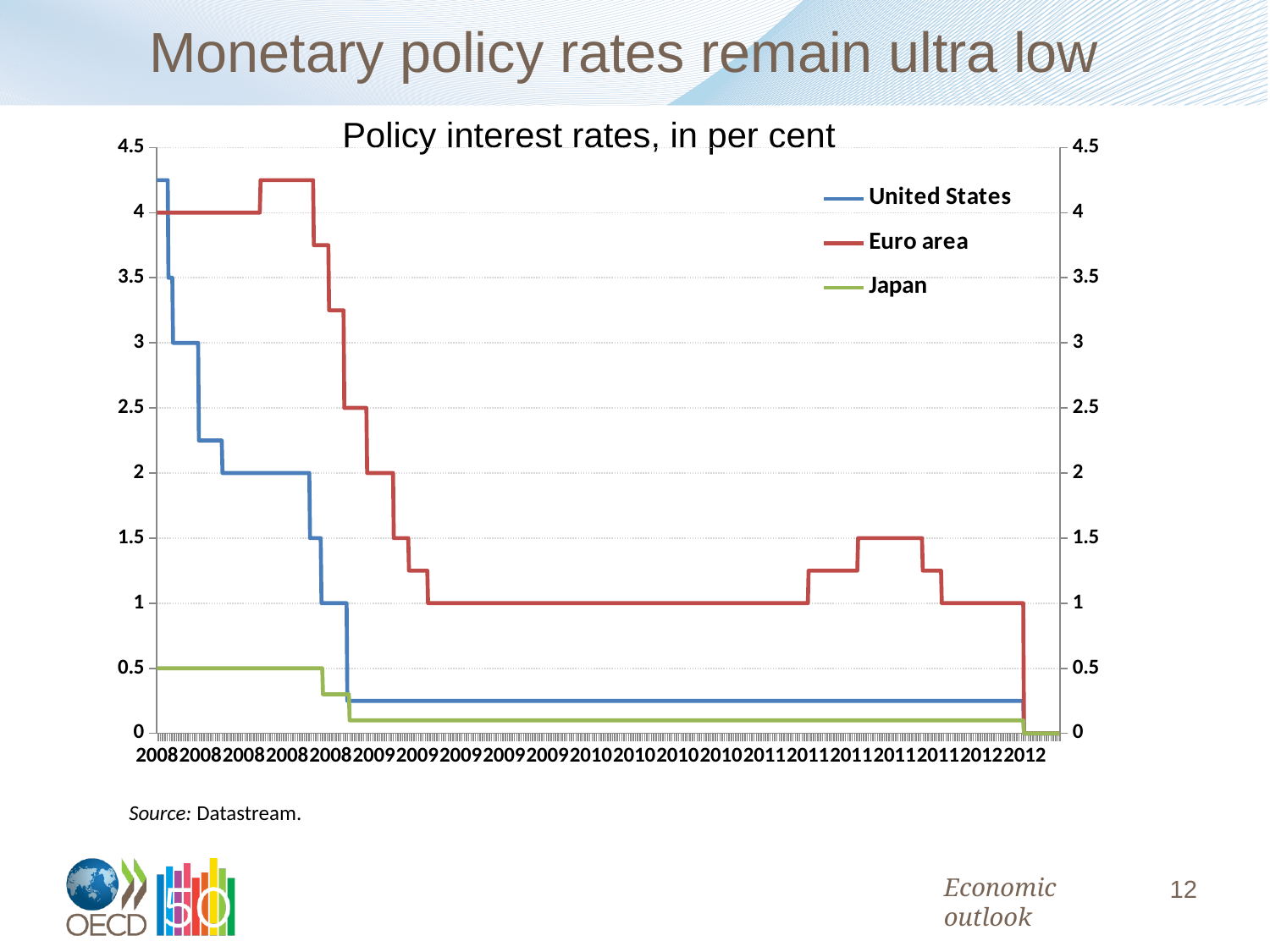
Is the United States policy rate in 2010 greater or less than 0.5? less What is the title of the chart? Policy interest rates, in per cent What was the Euro area policy rate throughout 2010? 1 What was the highest level the Euro area policy rate reached in 2011? 1.5 What kind of chart is shown on the slide? line chart How many series does the legend list? 3 Which three series are listed in the legend? United States, Euro area, Japan Which series had the lowest policy rate in 2010? Japan What was the Euro area policy rate at the start of 2008? 4 What was Japan's policy rate at the start of 2008? 0.5 In 2010, which was higher: the Euro area policy rate or the United States policy rate? Euro area Did the United States policy rate rise or fall over the course of 2008? fall